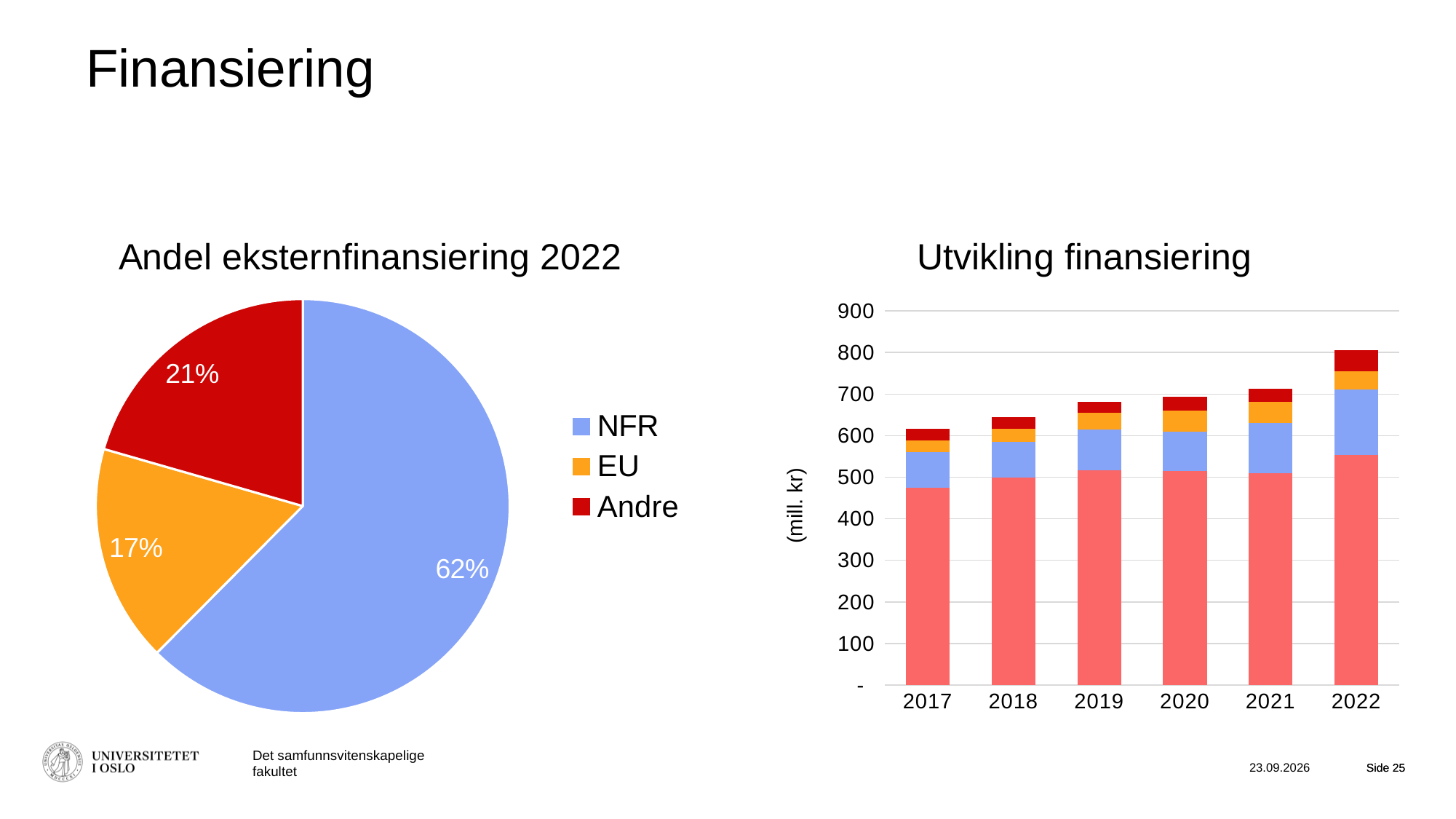
In the pie chart 'Andel eksternfinansiering 2022', how many percentage points larger is NFR's share than EU's share? 45 percentage points How many entries does the legend of the pie chart 'Andel eksternfinansiering 2022' list? 3 In the chart 'Utvikling finansiering', do the total bar heights rise or fall from 2017 to 2022? Rise In the chart 'Utvikling finansiering', is the total for 2022 greater or less than 700? greater How many years are shown on the x axis of the chart 'Utvikling finansiering'? 6 In the pie chart 'Andel eksternfinansiering 2022', what share does Andre have? 21% What kind of chart is 'Utvikling finansiering'? Stacked bar chart In the pie chart 'Andel eksternfinansiering 2022', what share does EU have? 17% In the pie chart 'Andel eksternfinansiering 2022', which category has the largest share? NFR In the pie chart 'Andel eksternfinansiering 2022', what share does NFR have? 62% In the pie chart 'Andel eksternfinansiering 2022', which is larger: the share for Andre or the share for EU? Andre In the pie chart 'Andel eksternfinansiering 2022', which category has the smallest share? EU